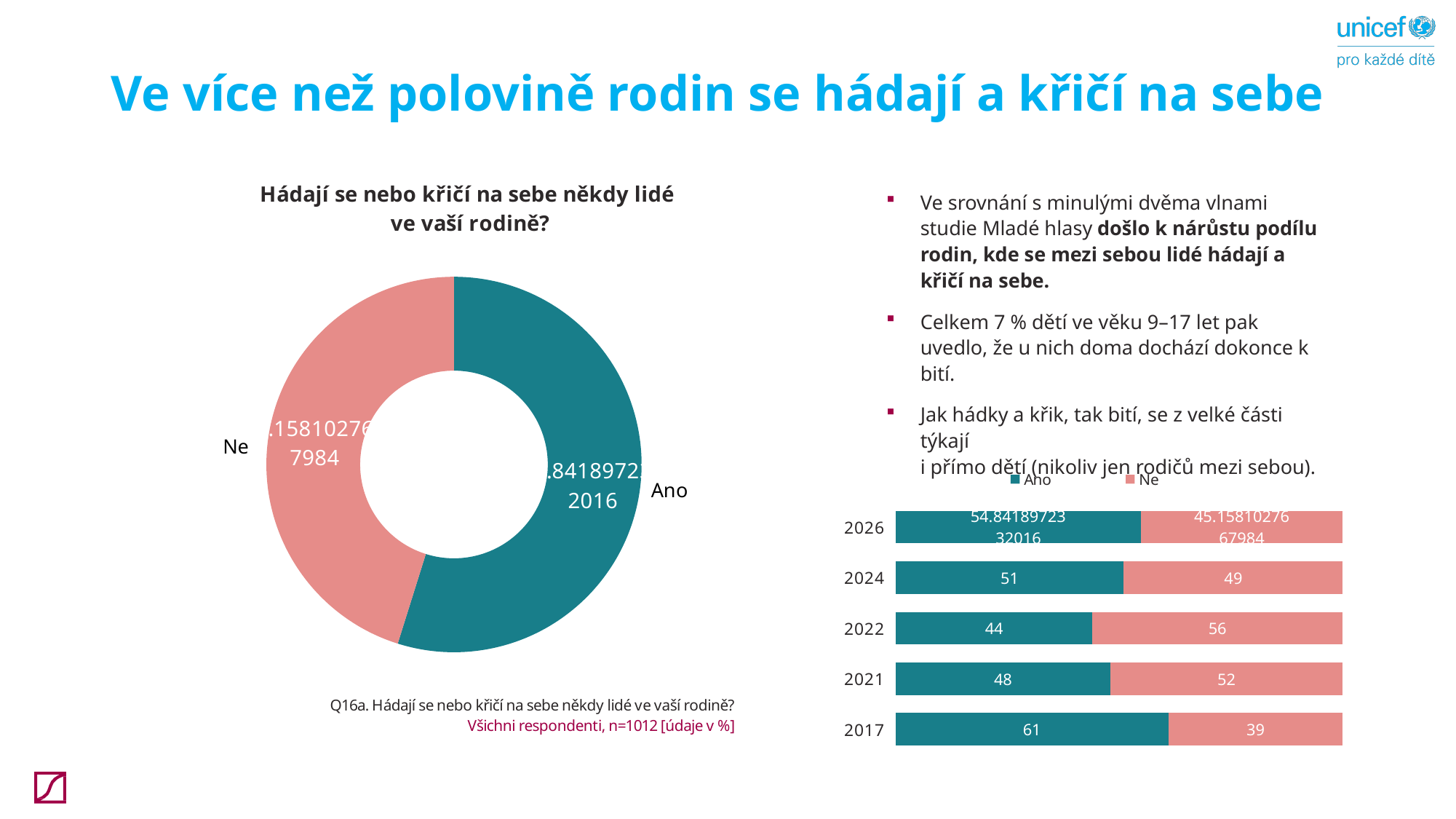
In the bar chart on the right, what is the difference between Ano and Ne in 2017? 22 In the bar chart on the right, what is the value for Ano in 2017? 61 In the bar chart on the right, what is the value for Ne in 2022? 56 In the bar chart on the right, which year has the highest value for Ano? 2017 In the bar chart on the right, which is larger in 2021, Ano or Ne? Ne What kind of chart is the chart on the right of the slide? bar chart How many years are shown in the bar chart on the right? 5 In the pie chart on the left, which slice is larger, Ano or Ne? Ano What kind of chart is the chart on the left of the slide? doughnut chart In the bar chart on the right, what is the value for Ano in 2024? 51 In the bar chart on the right, which year has the lowest value for Ano? 2022 How many series does the legend of the bar chart on the right list? 2